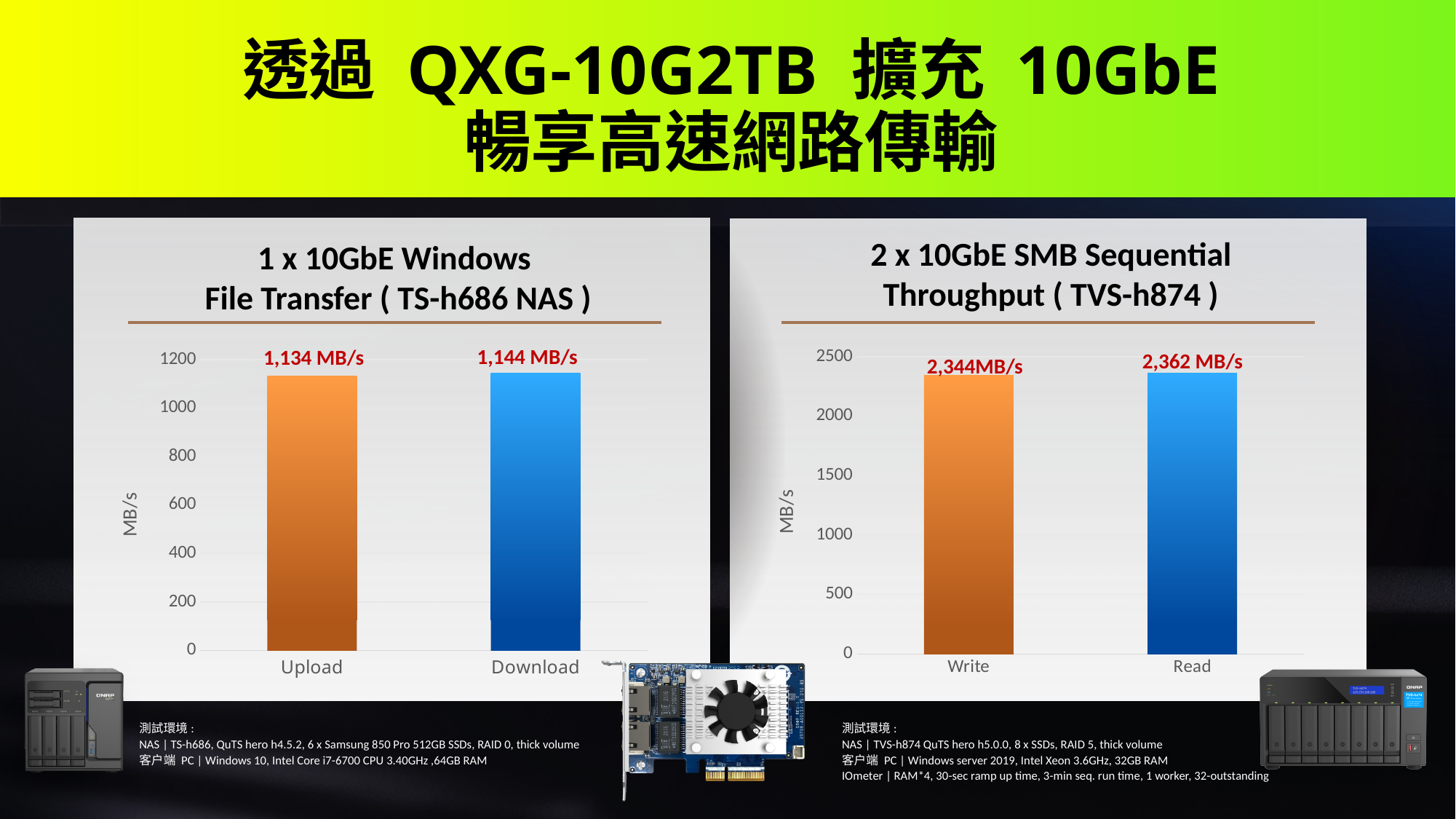
In the left chart (1 x 10GbE Windows File Transfer), what is the difference between the Download and Upload values? 10 MB/s How many categories are plotted in the right chart (2 x 10GbE SMB Sequential Throughput)? 2 In the right chart (2 x 10GbE SMB Sequential Throughput), what is the value for Read? 2,362 MB/s In the left chart (1 x 10GbE Windows File Transfer), what is the value for Upload? 1,134 MB/s In the left chart (1 x 10GbE Windows File Transfer), which category has the higher value according to the data labels? Download In the right chart (2 x 10GbE SMB Sequential Throughput), is the value for Read greater or less than 2500? less In the right chart (2 x 10GbE SMB Sequential Throughput), what is the value for Write? 2,344MB/s What type of chart is the left chart (1 x 10GbE Windows File Transfer)? Bar chart In the right chart (2 x 10GbE SMB Sequential Throughput), what is the difference between the Read and Write values? 18 MB/s In the left chart (1 x 10GbE Windows File Transfer), is the value for Upload greater or less than 1000? greater In the right chart (2 x 10GbE SMB Sequential Throughput), which category has the lower value according to the data labels? Write In the left chart (1 x 10GbE Windows File Transfer), what is the value for Download? 1,144 MB/s